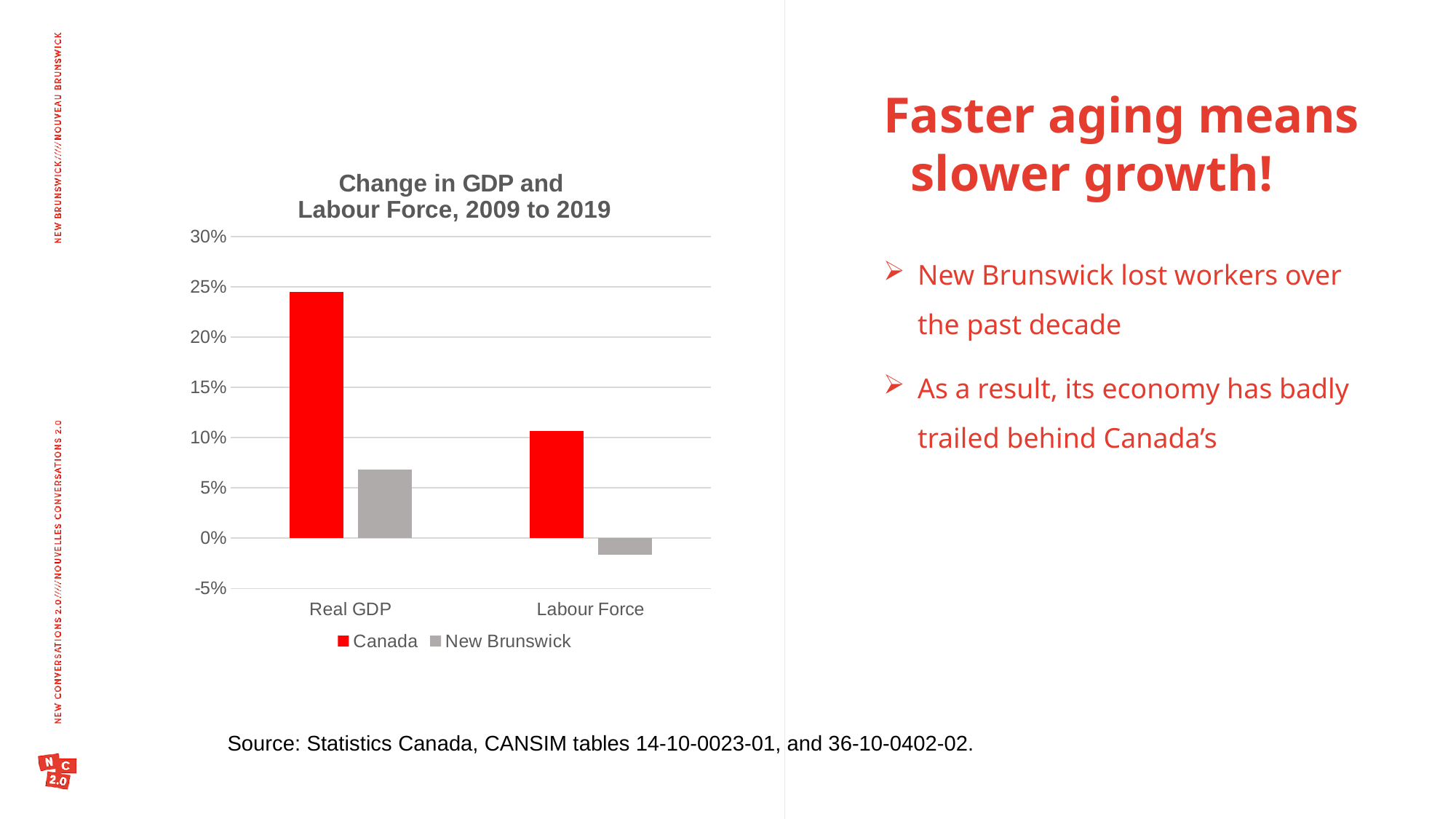
Is the value for Canada's Real GDP greater or less than 20%? greater Which series has the lowest value in the chart? New Brunswick How many categories are shown on the x axis? 2 Which series is shown in red? Canada Is the value for New Brunswick's Labour Force greater or less than 0%? less How many series does the legend list? 2 What is the title of the chart? Change in GDP and Labour Force, 2009 to 2019 What kind of chart is shown on the slide? bar chart Is the value for Canada's Labour Force greater or less than 5%? greater Which is larger for Real GDP, Canada or New Brunswick? Canada Which category has the highest Canada value? Real GDP